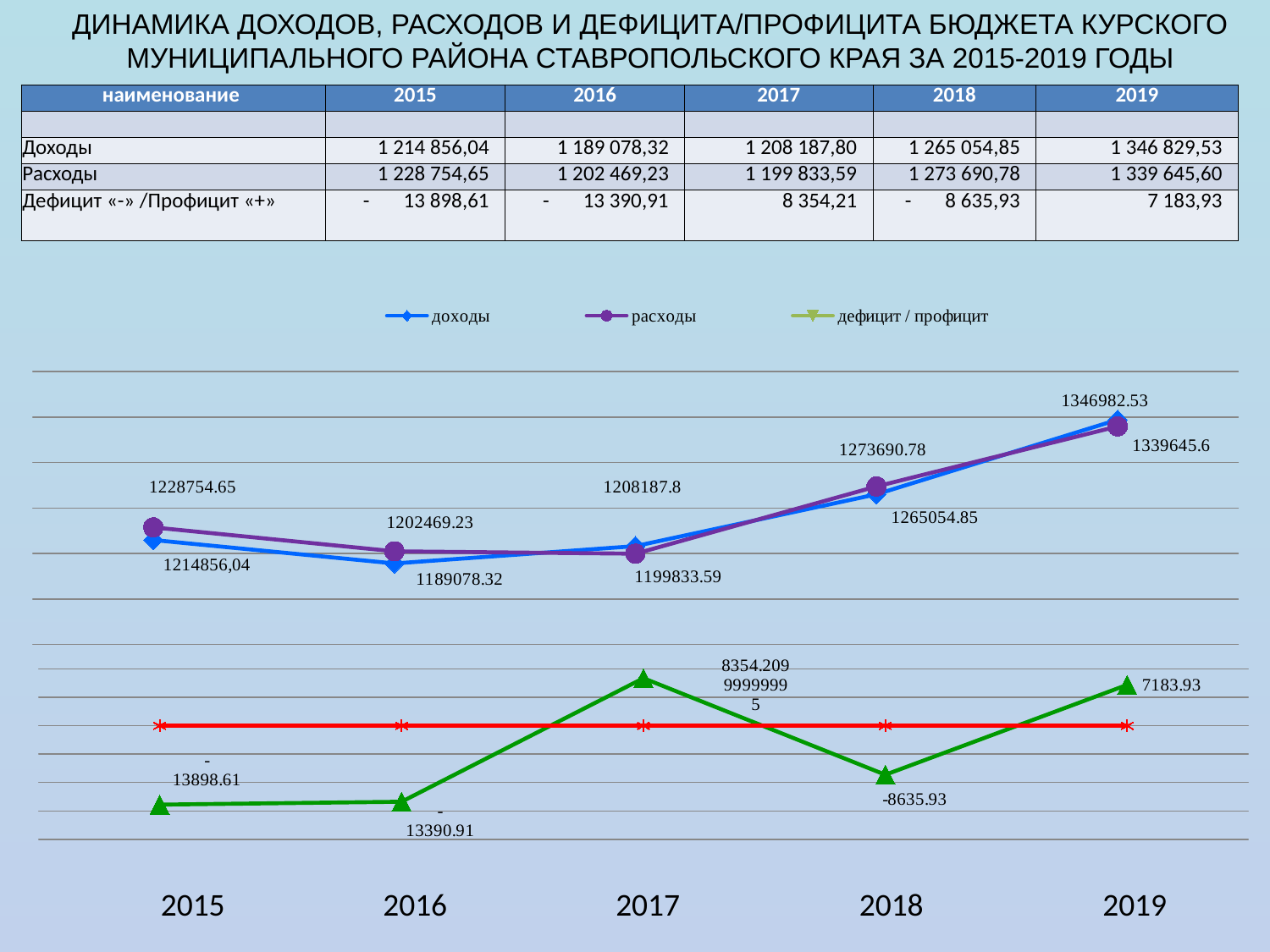
What is the value of дефицит / профицит for 2019 on the chart? 7183.93 In which year is доходы lowest on the chart? 2016 What is the value of расходы for 2015 on the chart? 1228754.65 What is the value of дефицит / профицит for 2018 on the chart? -8635.93 In which year is расходы highest on the chart? 2019 What is the value of доходы for 2016 on the chart? 1189078.32 On the chart, which is larger for 2018: доходы or расходы? расходы What kind of chart is shown on the slide? line chart How many series does the chart legend list? 3 How many years are plotted along the x axis of the chart? 5 What is the value of расходы for 2017 on the chart? 1199833.59 What is the difference between расходы in 2019 and расходы in 2018 on the chart? 65954.82